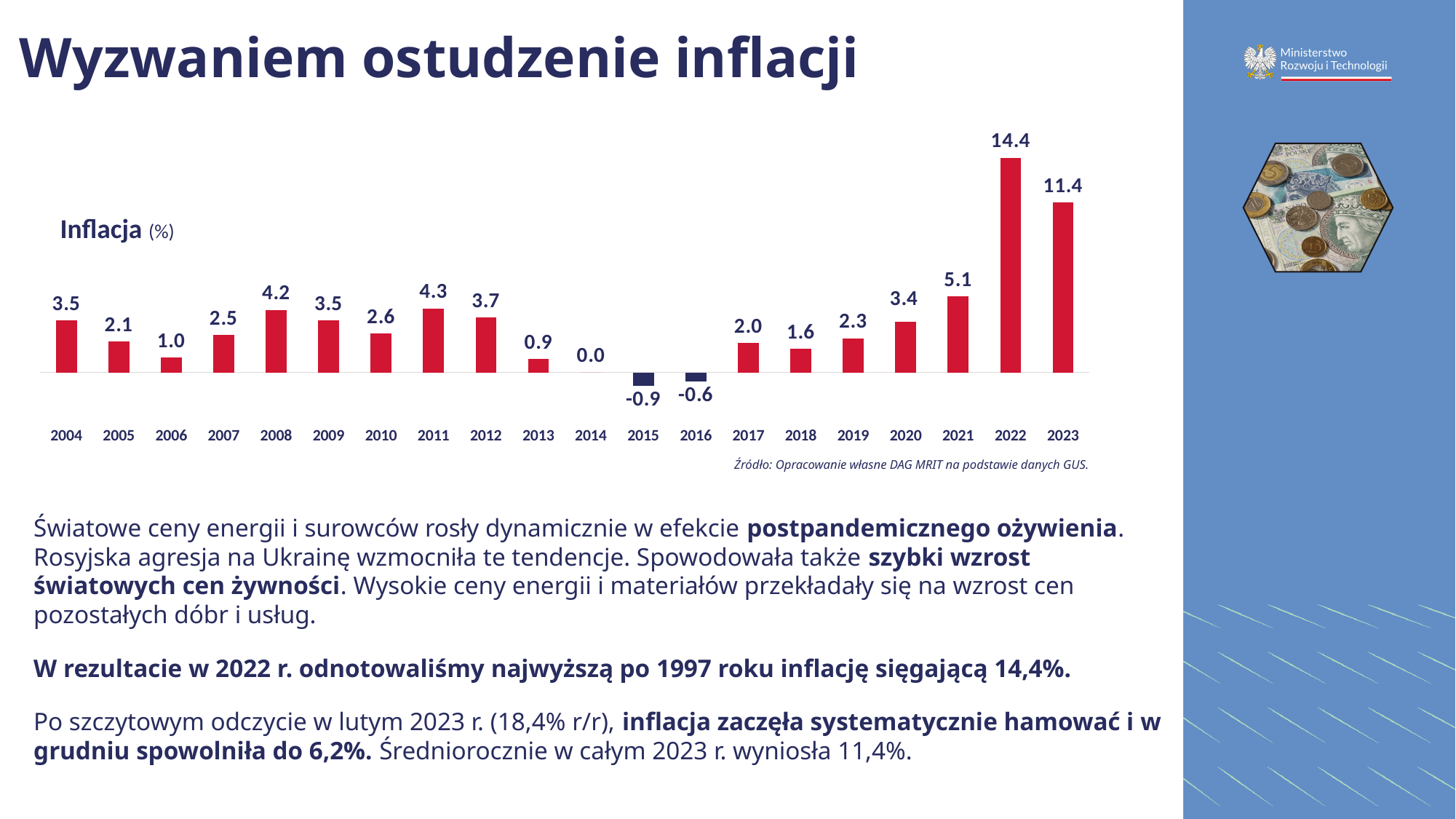
Which year has a higher inflation value, 2011 or 2012? 2011 How many years are shown on the x axis of the chart? 20 What is the title of the chart? Inflacja (%) Which year has the lowest inflation value in the chart? 2015 What was the inflation value for 2008? 4.2 Which year has the highest inflation value in the chart? 2022 What was the inflation value for 2022? 14.4 Do the inflation values rise or fall from 2019 to 2022? Rise How many years in the chart have a negative inflation value? 2 What kind of chart is shown on the slide? Bar chart What is the difference between the inflation values for 2022 and 2023? 3.0 What was the inflation value for 2015? -0.9